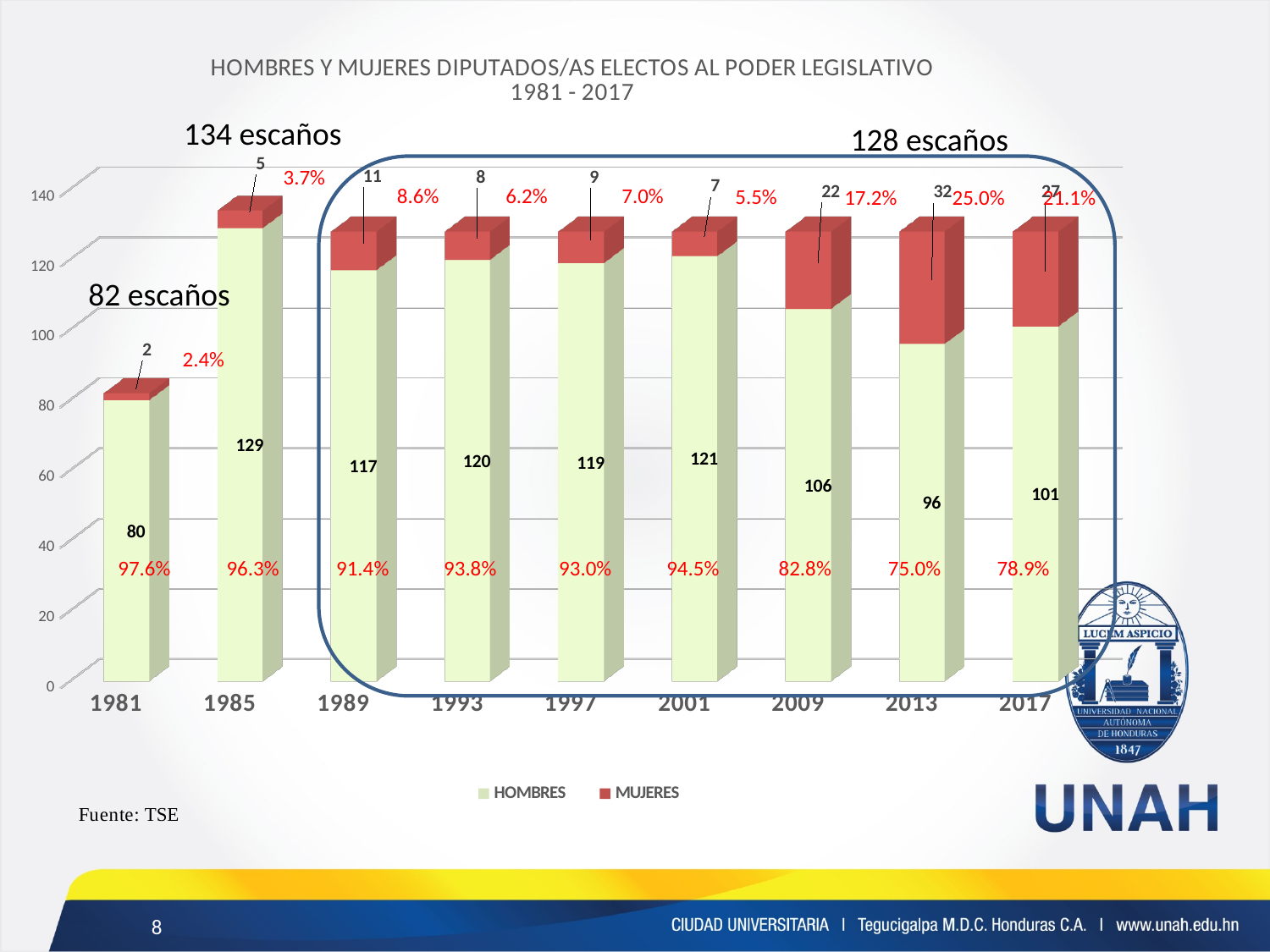
How many series does the legend list? 2 What kind of chart is shown? stacked bar chart What percentage is shown for MUJERES in 2009? 17.2% Is the MUJERES value for 2017 larger or smaller than the MUJERES value for 2009? larger What is the HOMBRES value for 1985? 129 What is the total of the stacked bar for 2017? 128 What is the difference between the HOMBRES values for 1985 and 2013? 33 What is the source cited below the chart? TSE Which year has the highest MUJERES value? 2013 What is the MUJERES value for 2013? 32 How many years are shown on the x axis? 9 Which year has the lowest HOMBRES value? 1981